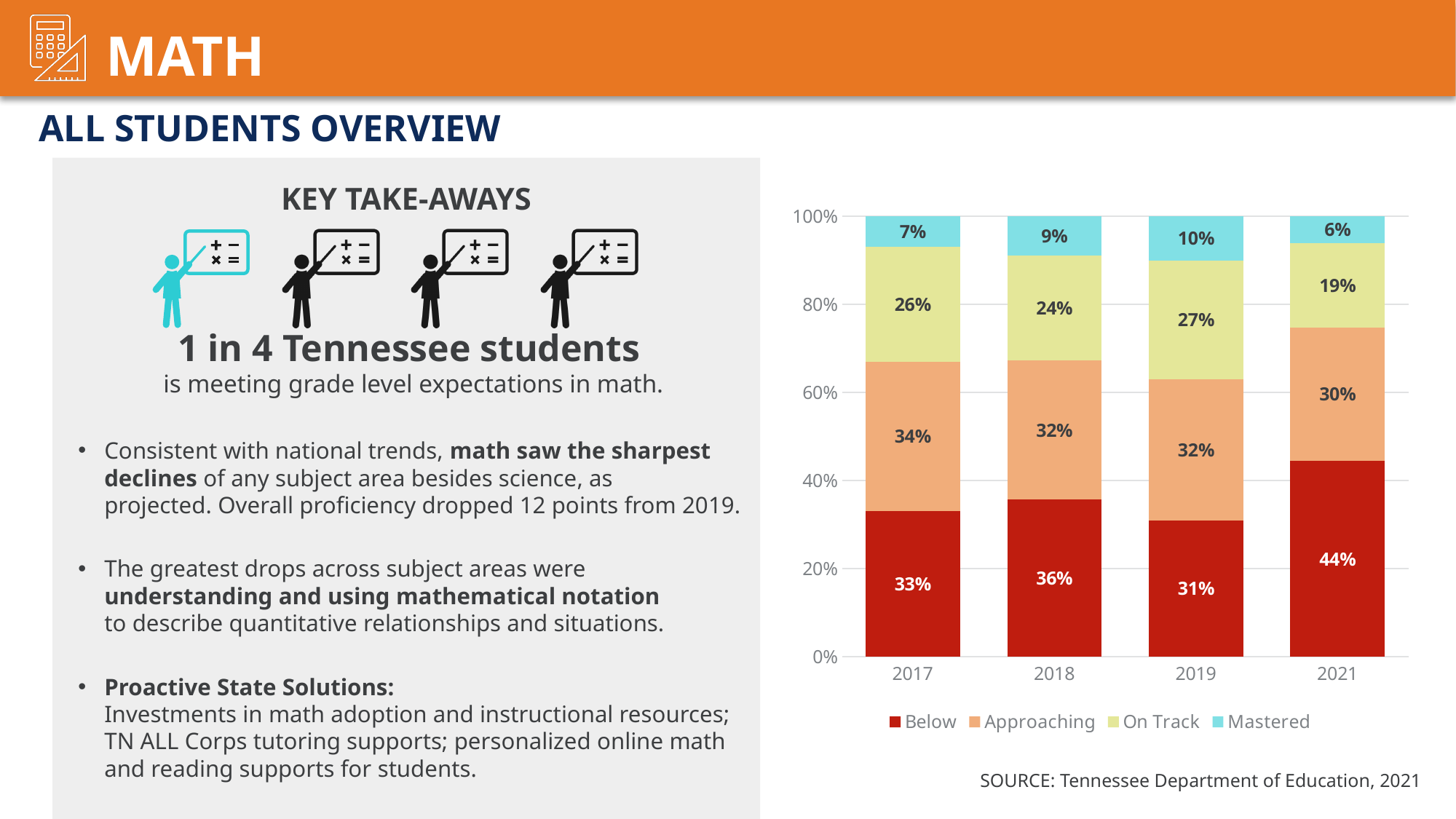
How many series does the chart legend list? 4 In which year was the Mastered share lowest? 2021 Which is larger: the On Track share in 2019 or in 2021? 2019 What percentage of students were On Track in 2018? 24% What is the combined share of On Track and Mastered students in 2021? 25% How many years are shown on the x axis of the chart? 4 What percentage of students were Below in 2021? 44% What kind of chart is shown on the slide? Stacked bar chart What is the difference between the Below share in 2021 and in 2019? 13% What percentage of students were Mastered in 2019? 10% What percentage of students were Approaching in 2017? 34% In which year was the Below share highest? 2021